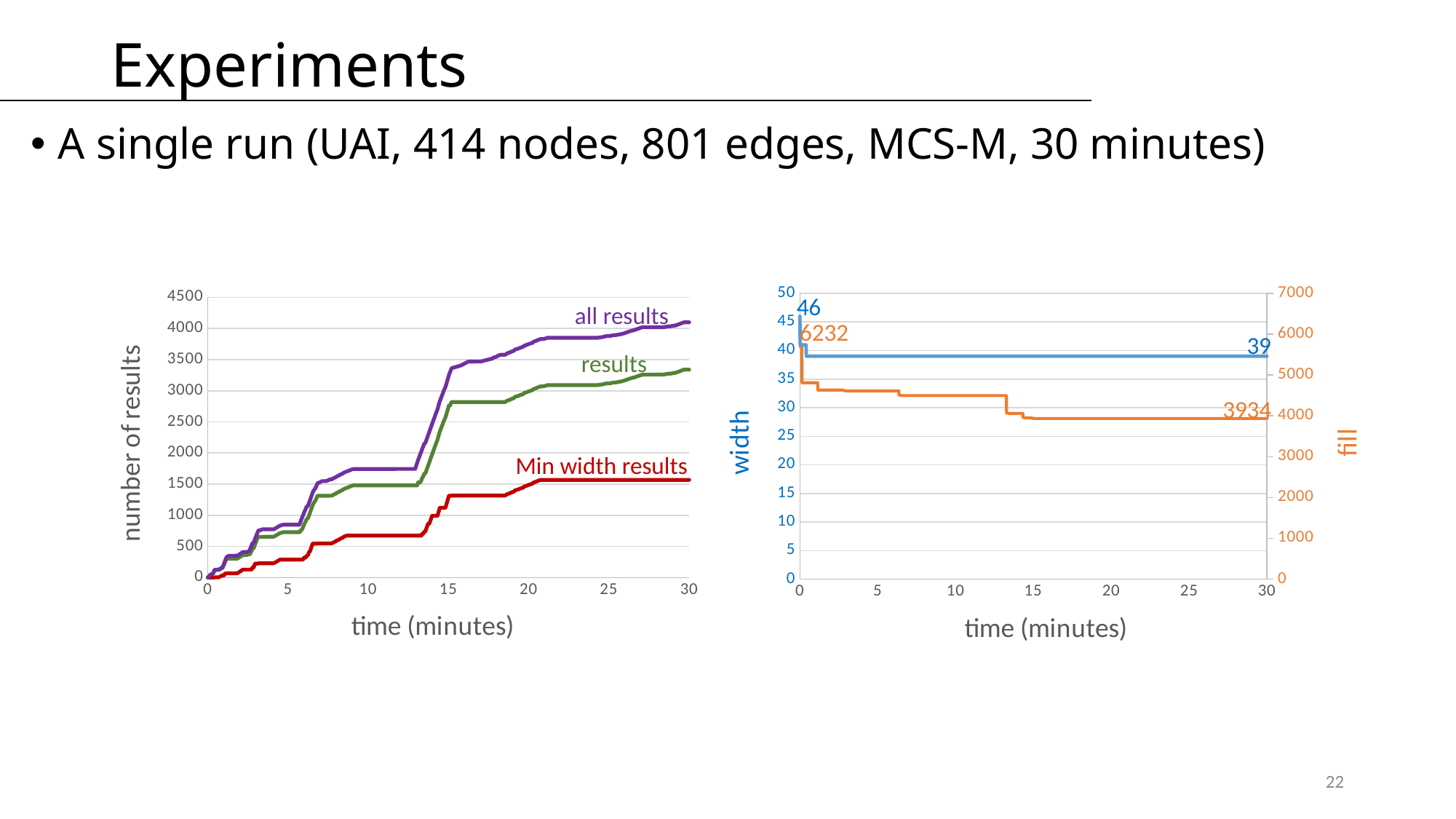
On the left chart, is the value of 'Min width results' at 30 minutes greater or less than 2000? less On the right chart, what is the final value of width at 30 minutes? 39 On the left chart, do the 'results' values rise or fall as time increases? rise On the left chart, is the value of 'all results' at 30 minutes greater or less than 4000? greater On the right chart, what is the starting value of width at time 0? 46 On the left chart, what kind of chart is it? line chart On the left chart, how many series are plotted? 3 On the left chart, which series has the highest number of results at 30 minutes? all results On the left chart, which series has the lowest number of results at 30 minutes? Min width results On the right chart, what is the final value of fill at 30 minutes? 3934 On the right chart, what is the difference between the starting and final fill values? 2298 On the right chart, what is the starting value of fill? 6232